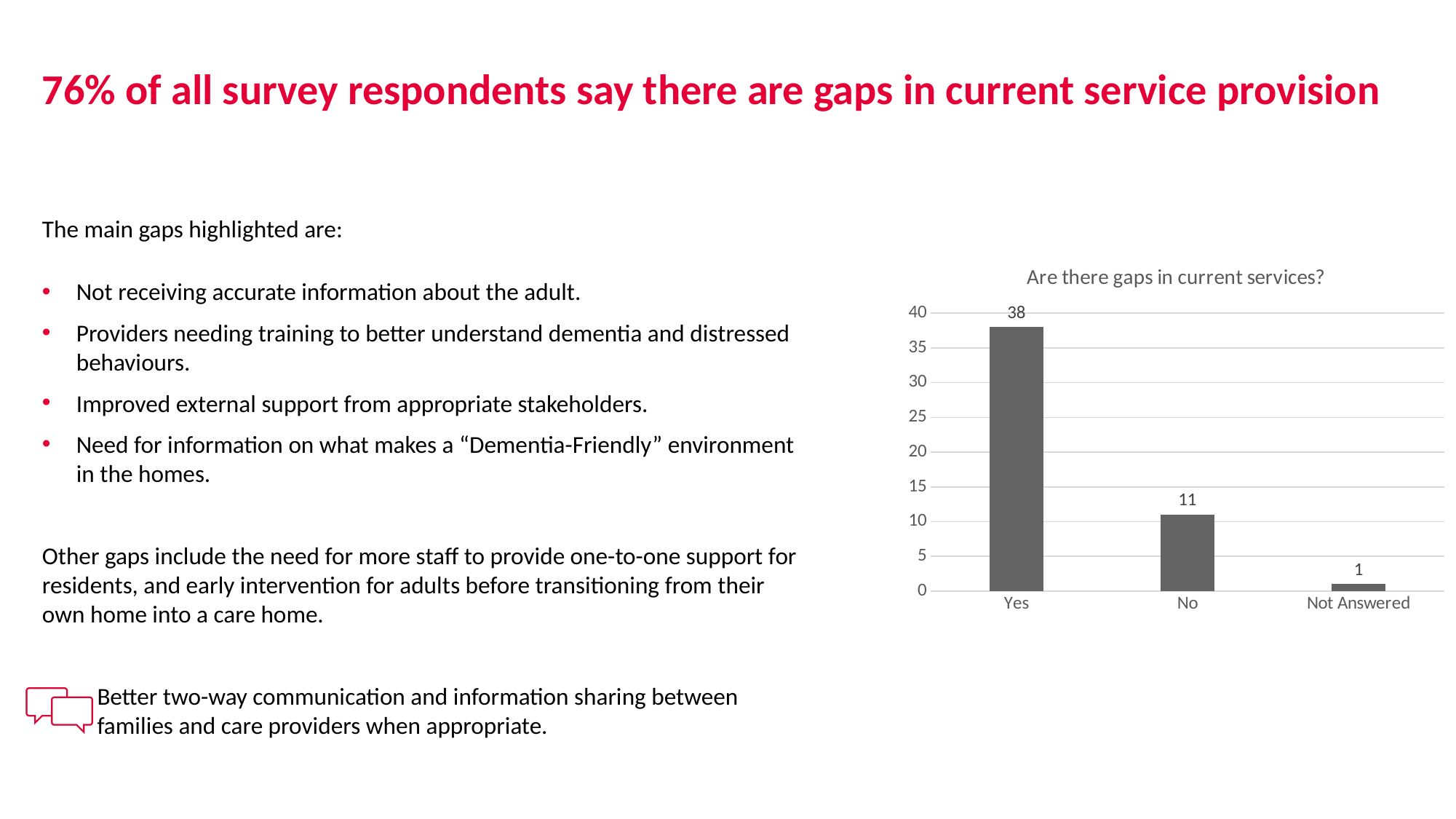
What kind of chart is shown on the slide? bar chart What is the difference between the values for Yes and No? 27 Which is larger, the value for Yes or the value for No? Yes What is the difference between the values for No and Not Answered? 10 Which category has the lowest value? Not Answered Is the value for No greater or less than 20? less What is the value for No? 11 How many categories are shown on the x axis? 3 Which category has the highest value? Yes What is the value for Not Answered? 1 What is the value for Yes? 38 What is the title of the chart? Are there gaps in current services?